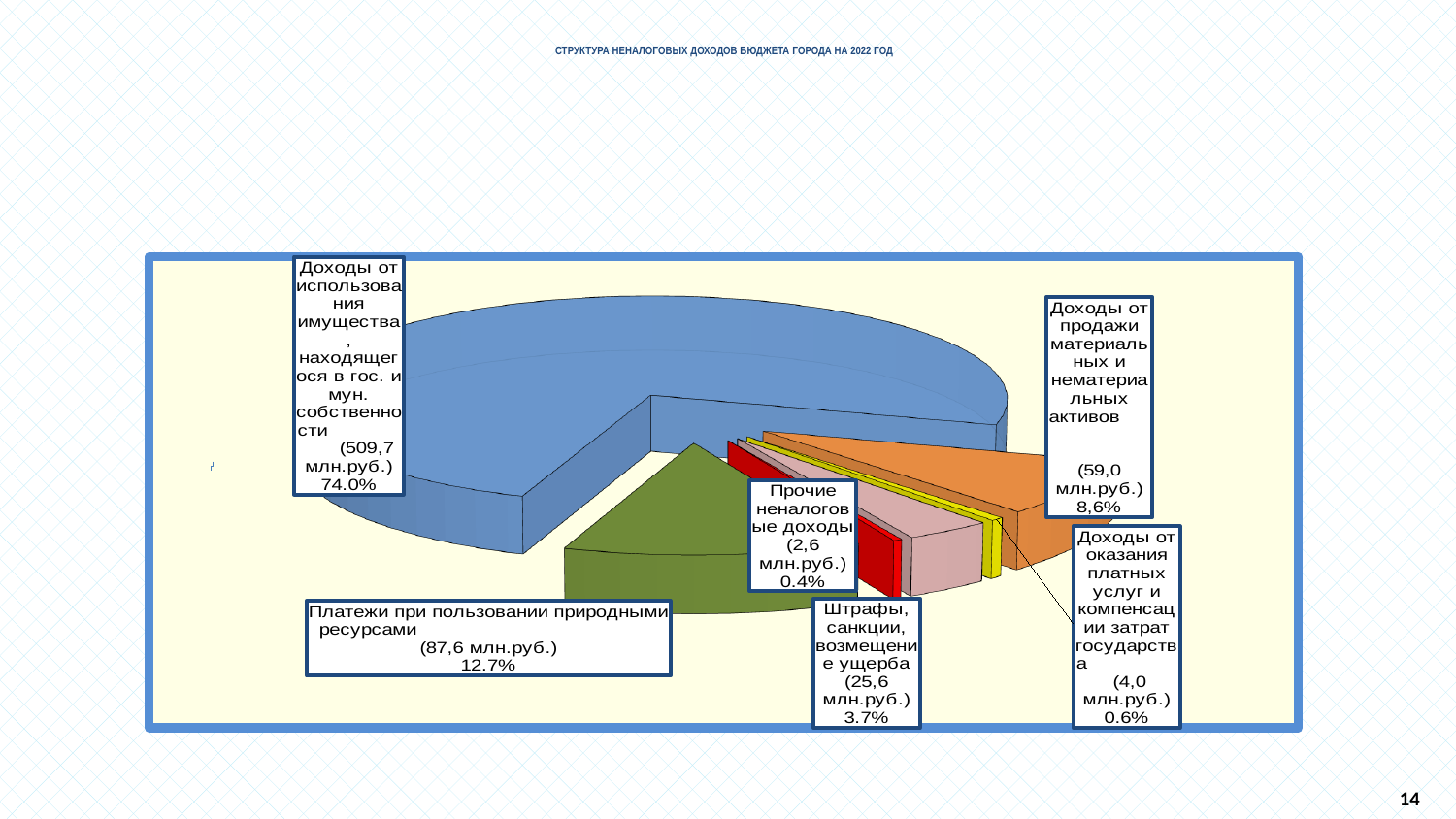
Which category has the smallest share of the pie? Прочие неналоговые доходы What percentage share is shown for "Штрафы, санкции, возмещение ущерба"? 3.7% How many slices does the pie chart have? 6 Which is larger: "Штрафы, санкции, возмещение ущерба" or "Доходы от продажи материальных и нематериальных активов"? Доходы от продажи материальных и нематериальных активов What is the difference in percentage points between the share of "Платежи при пользовании природными ресурсами" (12.7%) and "Доходы от продажи материальных и нематериальных активов" (8,6%)? 4.1 What is the value shown for "Доходы от оказания платных услуг и компенсации затрат государства"? 4,0 млн.руб. What kind of chart is shown on the slide? Pie chart What percentage share is shown for "Прочие неналоговые доходы"? 0.4% What is the title of the slide? СТРУКТУРА НЕНАЛОГОВЫХ ДОХОДОВ БЮДЖЕТА ГОРОДА НА 2022 ГОД What is the value shown for "Платежи при пользовании природными ресурсами"? 87,6 млн.руб. Which category has the largest share of the pie? Доходы от использования имущества, находящегося в гос. и мун. собственности What is the value shown for "Доходы от продажи материальных и нематериальных активов"? 59,0 млн.руб.